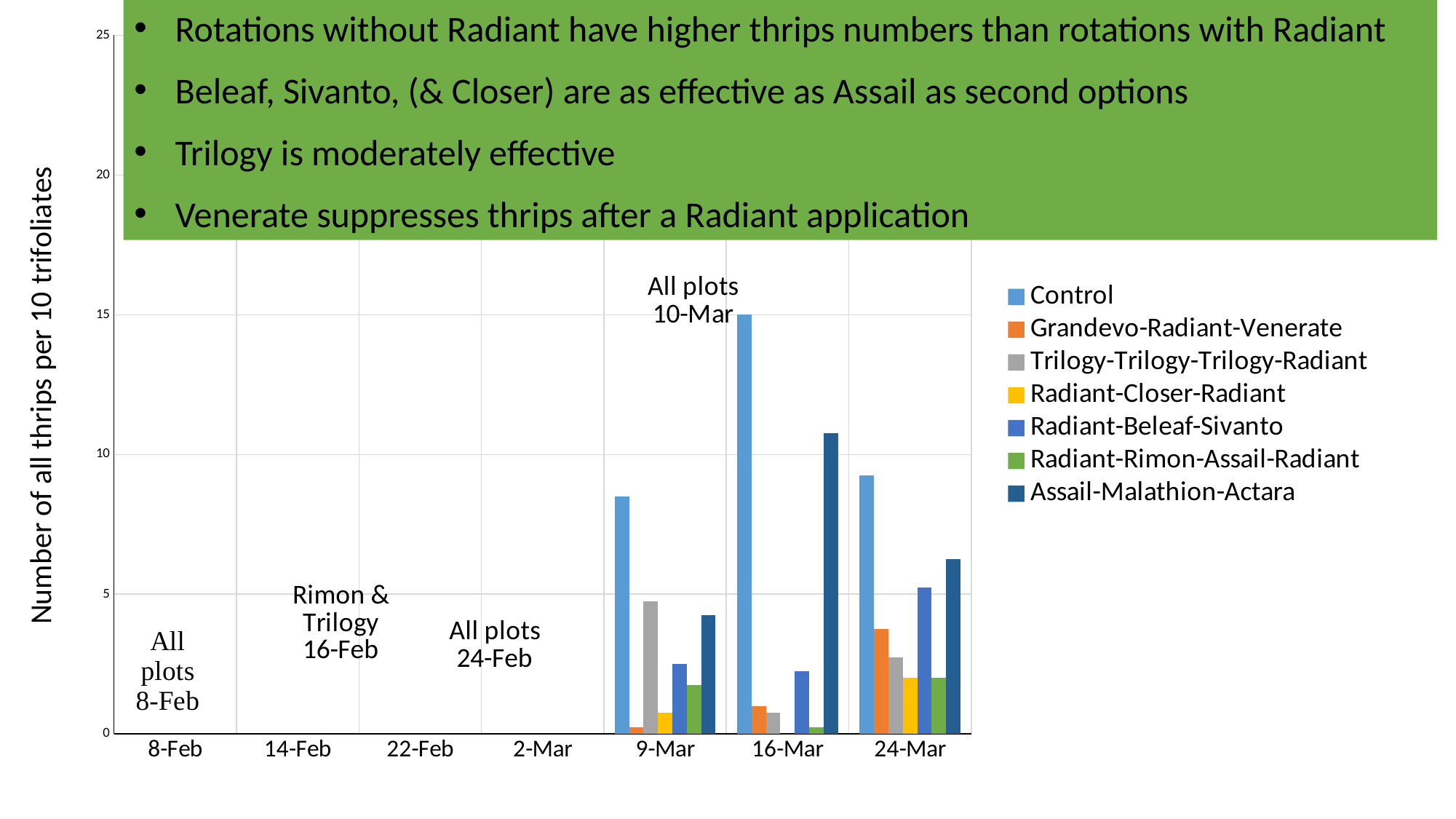
Is the value for Control on 9-Mar greater or less than 5? greater Which series has the lowest value on 9-Mar? Grandevo-Radiant-Venerate Which series has the highest value on 16-Mar? Control How many series does the legend list? 7 Which series has the highest value on 9-Mar? Control Is the value for Control on 16-Mar greater or less than 10? greater Does the Control value rise or fall from 9-Mar to 16-Mar? rise What is the title of the y axis? Number of all thrips per 10 trifoliates Which is larger for Assail-Malathion-Actara: the value on 9-Mar or on 24-Mar? 24-Mar How many dates are shown on the x axis? 7 What kind of chart is shown on the slide? bar chart Is the value for Assail-Malathion-Actara on 16-Mar greater or less than 10? greater